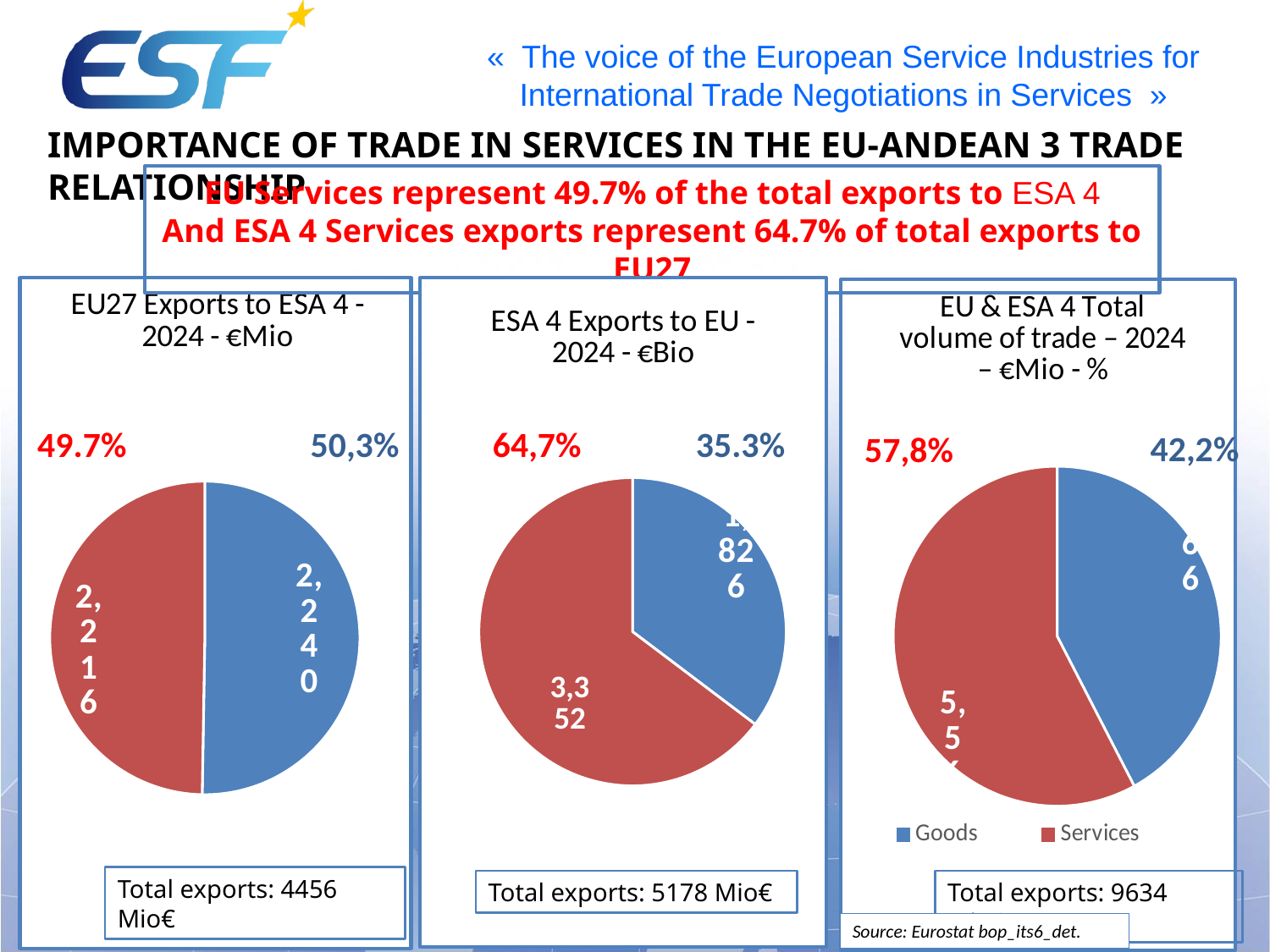
In the 'ESA 4 Exports to EU - 2024 - €Bio' chart, which slice is larger, the red one or the blue one? Red In the 'EU27 Exports to ESA 4 - 2024 - €Mio' chart, what percentage is shown for the red slice? 49.7% In the 'ESA 4 Exports to EU - 2024 - €Bio' chart, what percentage is shown for the red slice? 64,7% In the 'EU & ESA 4 Total volume of trade – 2024' chart, what total exports figure is given below the chart? 9634 In the 'EU & ESA 4 Total volume of trade – 2024' chart, what share is shown for Services? 57,8% In the 'EU27 Exports to ESA 4 - 2024 - €Mio' chart, what is the difference between the blue slice value (2,240) and the red slice value (2,216)? 24 What kind of chart is used on this slide? Pie chart How many pie charts are shown on the slide? 3 In the 'ESA 4 Exports to EU - 2024 - €Bio' chart, what value is printed on the red slice? 3,352 In the 'EU27 Exports to ESA 4 - 2024 - €Mio' chart, what value is printed on the blue slice? 2,240 In the 'EU27 Exports to ESA 4 - 2024 - €Mio' chart, what total exports figure is given below the chart? 4456 Mio€ In the 'EU & ESA 4 Total volume of trade – 2024' chart, how many entries does the legend list? 2